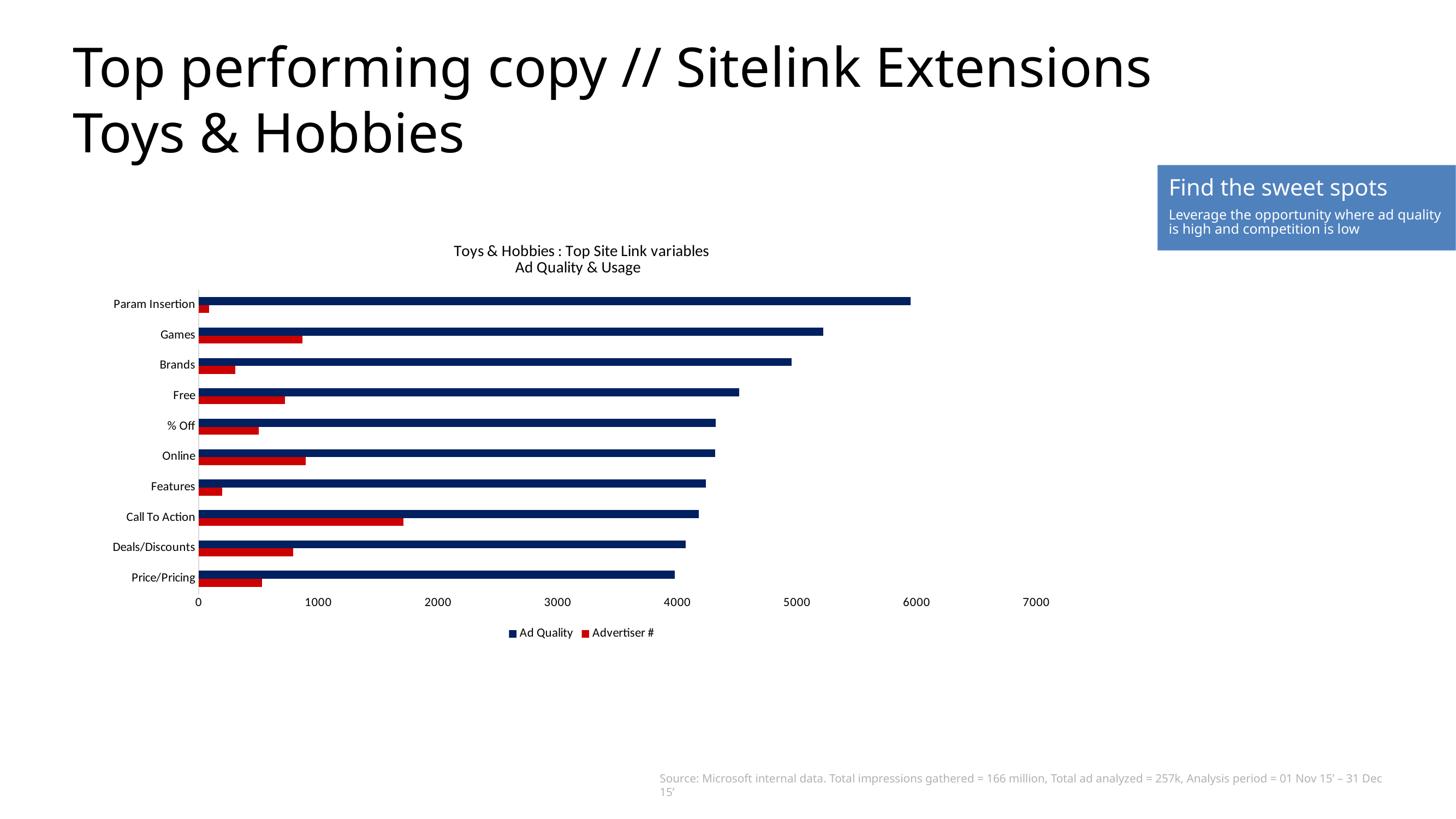
Which has the larger Advertiser # value, Call To Action or Games? Call To Action Is the Advertiser # value for Games greater or less than 1000? less Which colour represents the Advertiser # series in the chart? Red How many series does the legend list? 2 Which category has the highest Advertiser # value? Call To Action Which category has the highest Ad Quality value? Param Insertion What kind of chart is shown on the slide? Bar chart How many categories are plotted on the chart? 10 Is the Advertiser # value for Call To Action greater or less than 1000? greater Which has the larger Ad Quality value, Games or Brands? Games Which category has the lowest Advertiser # value? Param Insertion Is the Ad Quality value for Param Insertion greater or less than 5000? greater